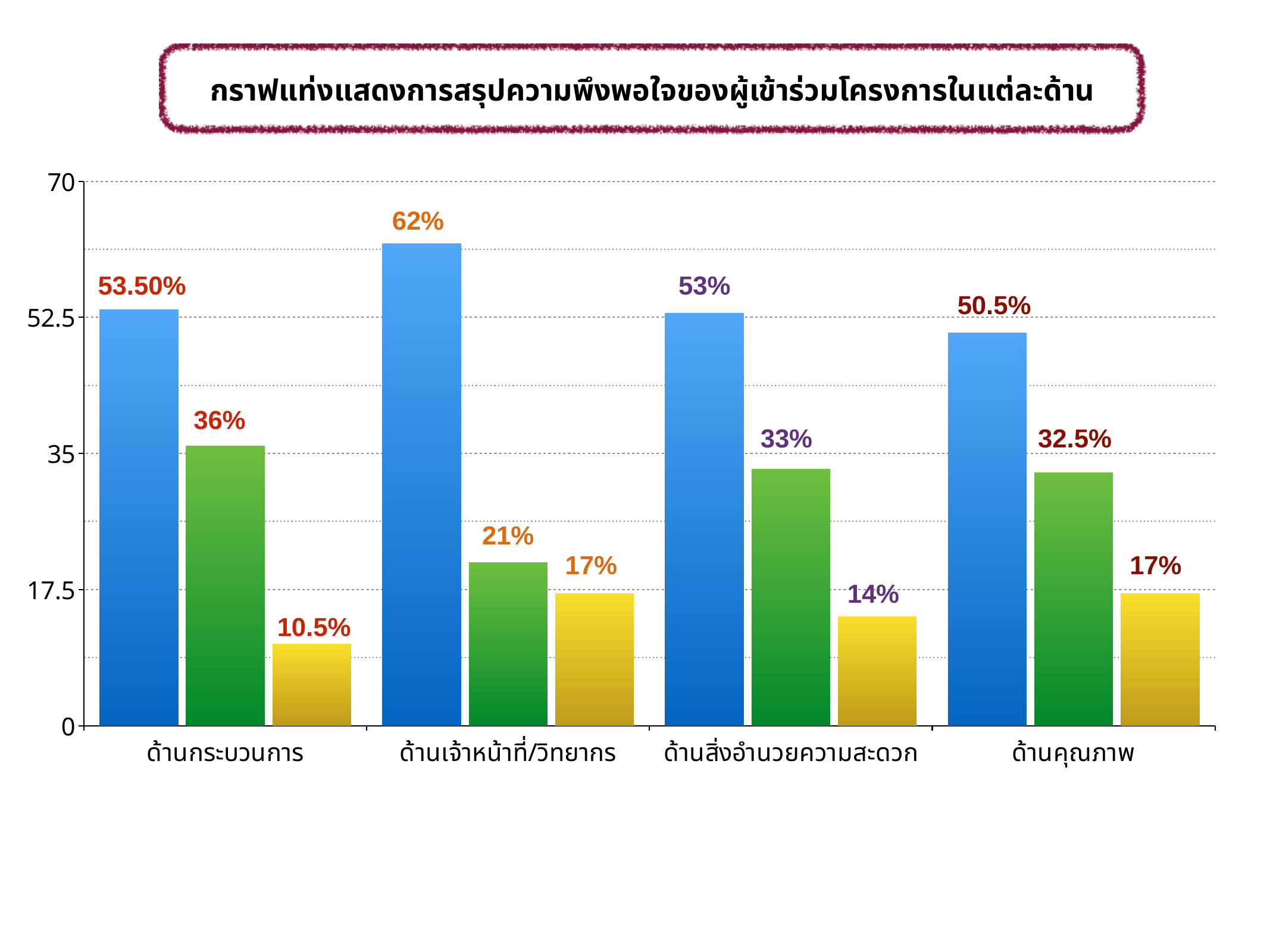
Which category has the highest blue bar? ด้านเจ้าหน้าที่/วิทยากร What is the difference between the blue bar and the green bar for ด้านเจ้าหน้าที่/วิทยากร? 41% How many bars are shown for each category? 3 What is the value of the green bar for ด้านเจ้าหน้าที่/วิทยากร? 21% Which category has the lowest yellow bar? ด้านกระบวนการ What is the value of the blue bar for ด้านกระบวนการ? 53.50% Which is larger: the green bar for ด้านกระบวนการ or the green bar for ด้านสิ่งอำนวยความสะดวก? ด้านกระบวนการ Is the blue bar for ด้านคุณภาพ greater or less than 52.5? less What is the value of the green bar for ด้านคุณภาพ? 32.5% How many categories are shown on the x axis? 4 What kind of chart is shown on the slide? bar chart What is the value of the yellow bar for ด้านสิ่งอำนวยความสะดวก? 14%